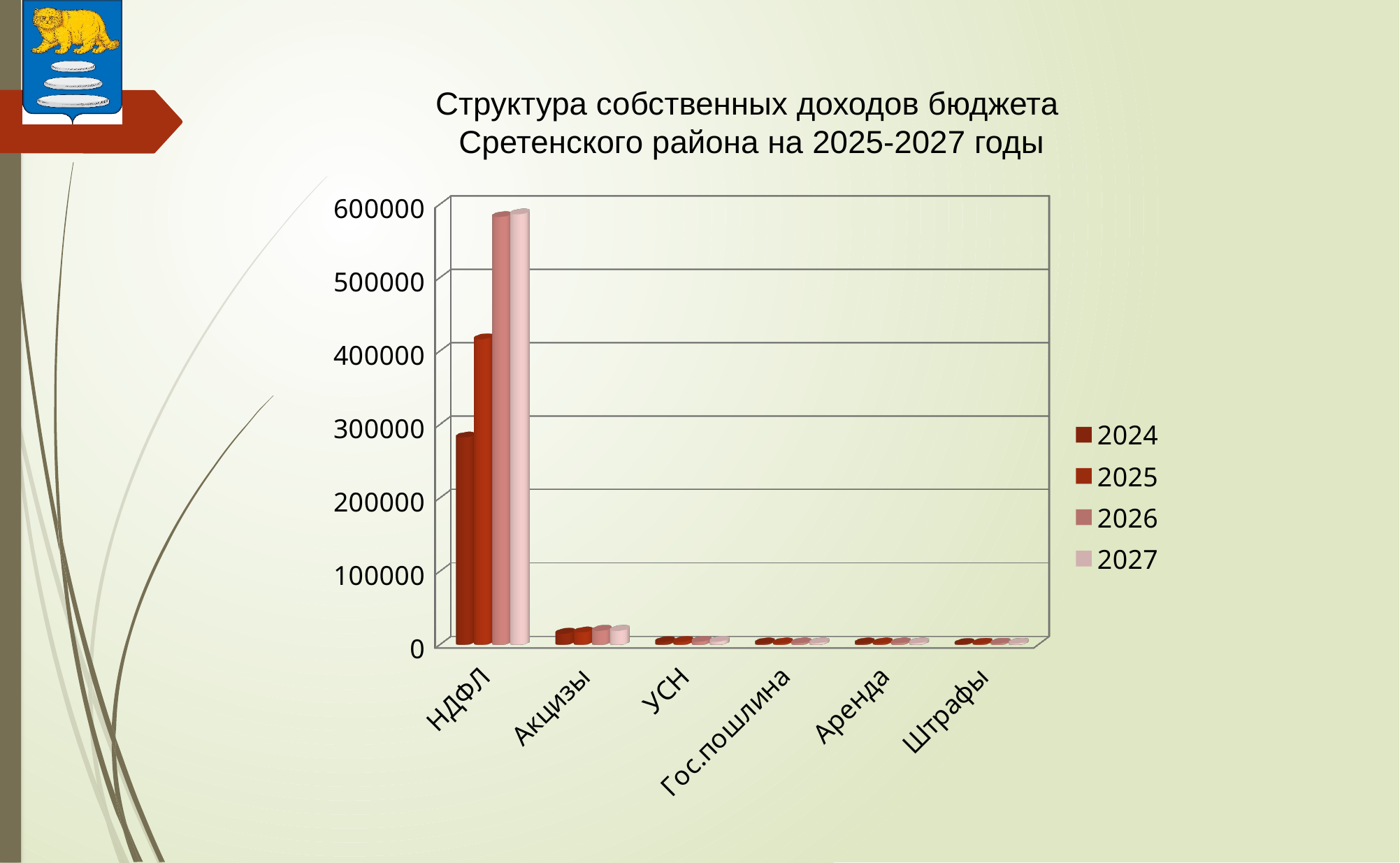
Is the 2027 value for Акцизы greater or less than 100000? less What kind of chart is shown on the slide? bar chart How many series does the chart's legend list? 4 What is the title of the chart? Структура собственных доходов бюджета Сретенского района на 2025-2027 годы Is the 2026 value for НДФЛ greater or less than 500000? greater How many categories are shown on the x axis of the chart? 6 For НДФЛ, which is larger: the 2025 value or the 2026 value? 2026 Do the НДФЛ values rise or fall from 2024 to 2027? rise Which category has the highest values in the chart? НДФЛ Is the 2025 value for НДФЛ greater or less than 400000? greater For НДФЛ, which is larger: the 2024 value or the 2025 value? 2025